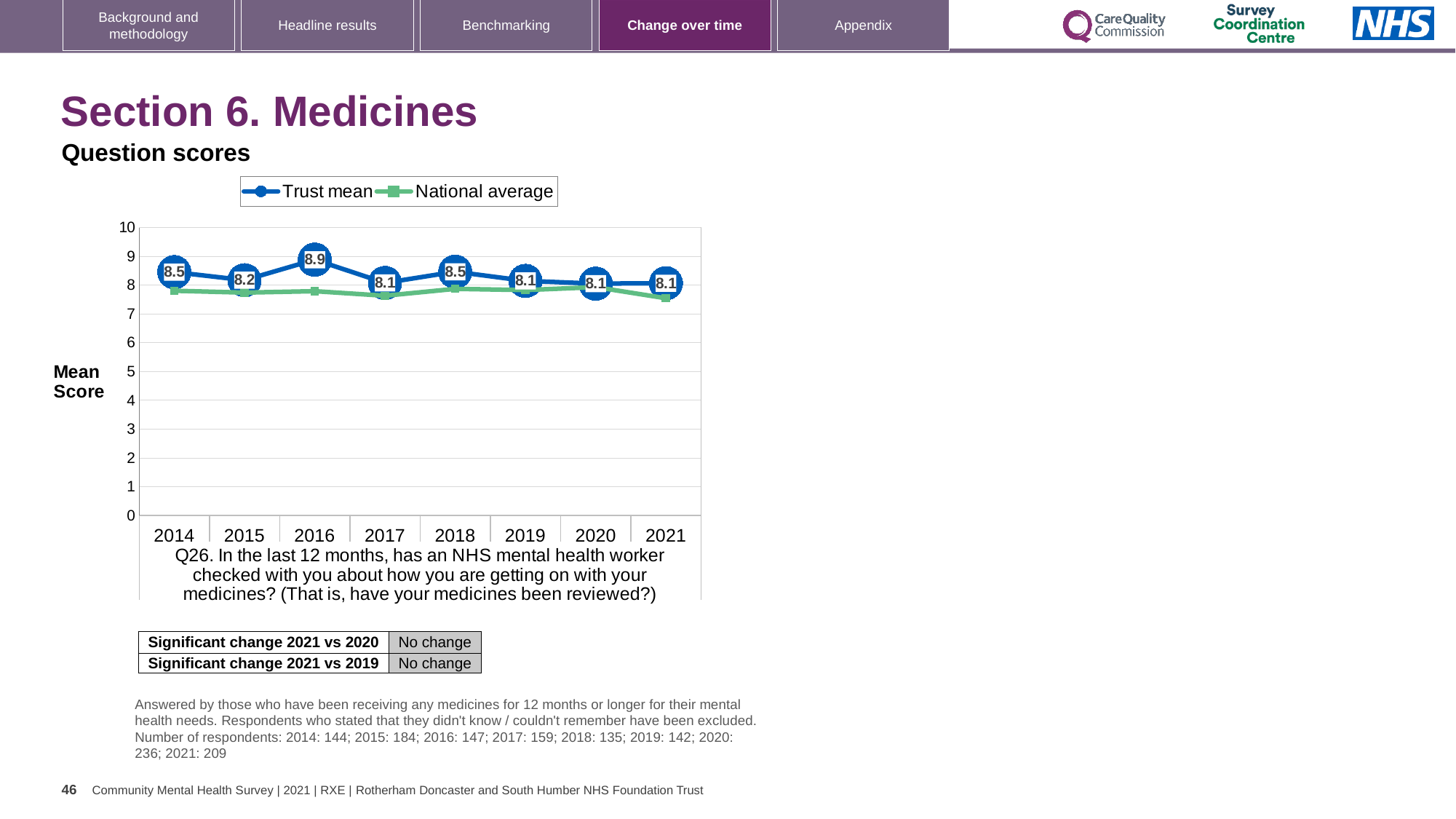
In which year is the Trust mean score highest? 2016 What is the difference between the Trust mean scores for 2016 and 2015? 0.7 What is the Trust mean score for 2021? 8.1 What kind of chart is shown on the slide? line chart What is the Trust mean score for 2014? 8.5 What is the Trust mean score for 2016? 8.9 Which year has the larger Trust mean score, 2014 or 2015? 2014 How many years are shown on the x axis of the chart? 8 Is the Trust mean value for 2016 greater or less than 8? greater Is the National average value for 2021 greater or less than 8? less How many series does the legend list? 2 Does the Trust mean score rise or fall from 2016 to 2017? fall